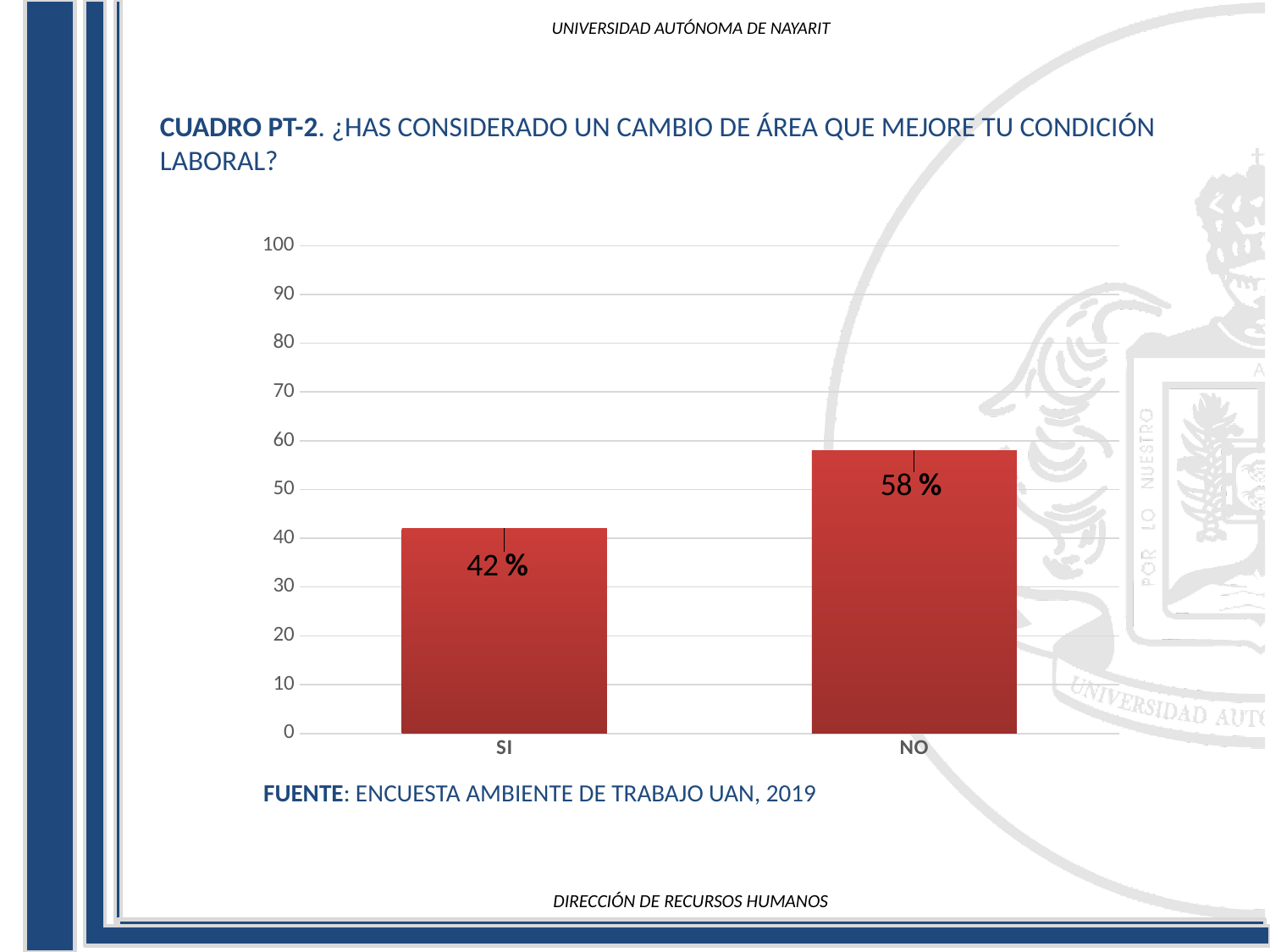
What is the value for NO? 58 % Which category has the highest value? NO What is the value for SI? 42 % What kind of chart is shown on the slide? bar chart Which is larger, the value for SI or the value for NO? NO How many categories are shown on the x axis? 2 What is the maximum value shown on the y axis? 100 Is the value for NO greater or less than 50? greater Is the value for SI greater or less than 50? less What is the difference between the values for NO and SI? 16 % Which category has the lowest value? SI What source is cited below the chart? ENCUESTA AMBIENTE DE TRABAJO UAN, 2019